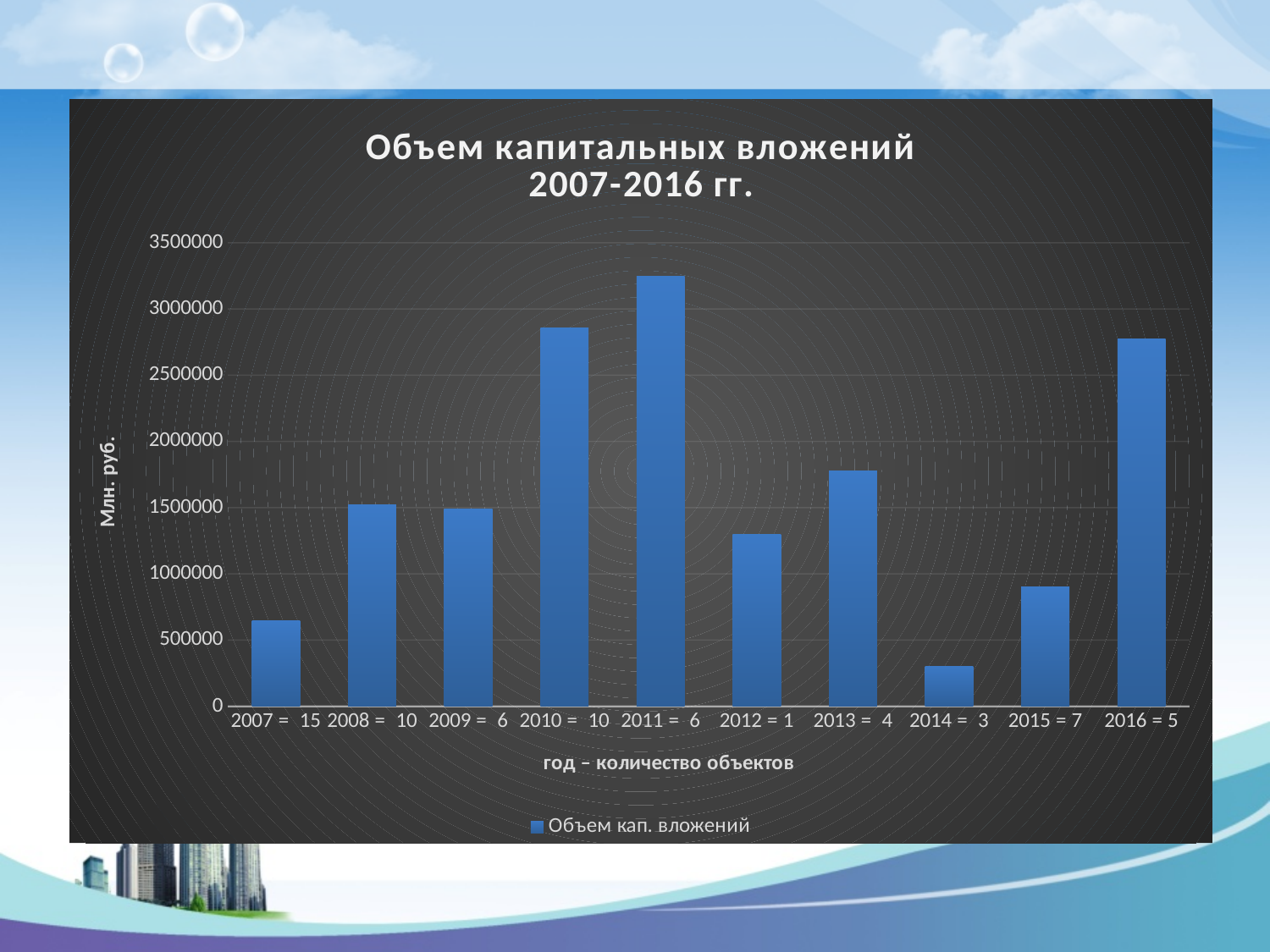
What is the label of the y axis? Млн. руб. How many series does the legend list? 1 Is the value for 2014 greater or less than 500000? less Is the value for 2015 greater or less than 1000000? less Which year has the lowest volume of capital investments? 2014 How many categories (years) are shown on the x axis? 10 What kind of chart is shown on the slide? Bar chart Which year has the highest volume of capital investments? 2011 Do the values rise or fall from 2011 to 2014? fall What is the title of the chart? Объем капитальных вложений 2007-2016 гг. Is the value for 2011 greater or less than 3000000? greater Which is larger, the value for 2013 or the value for 2012? 2013